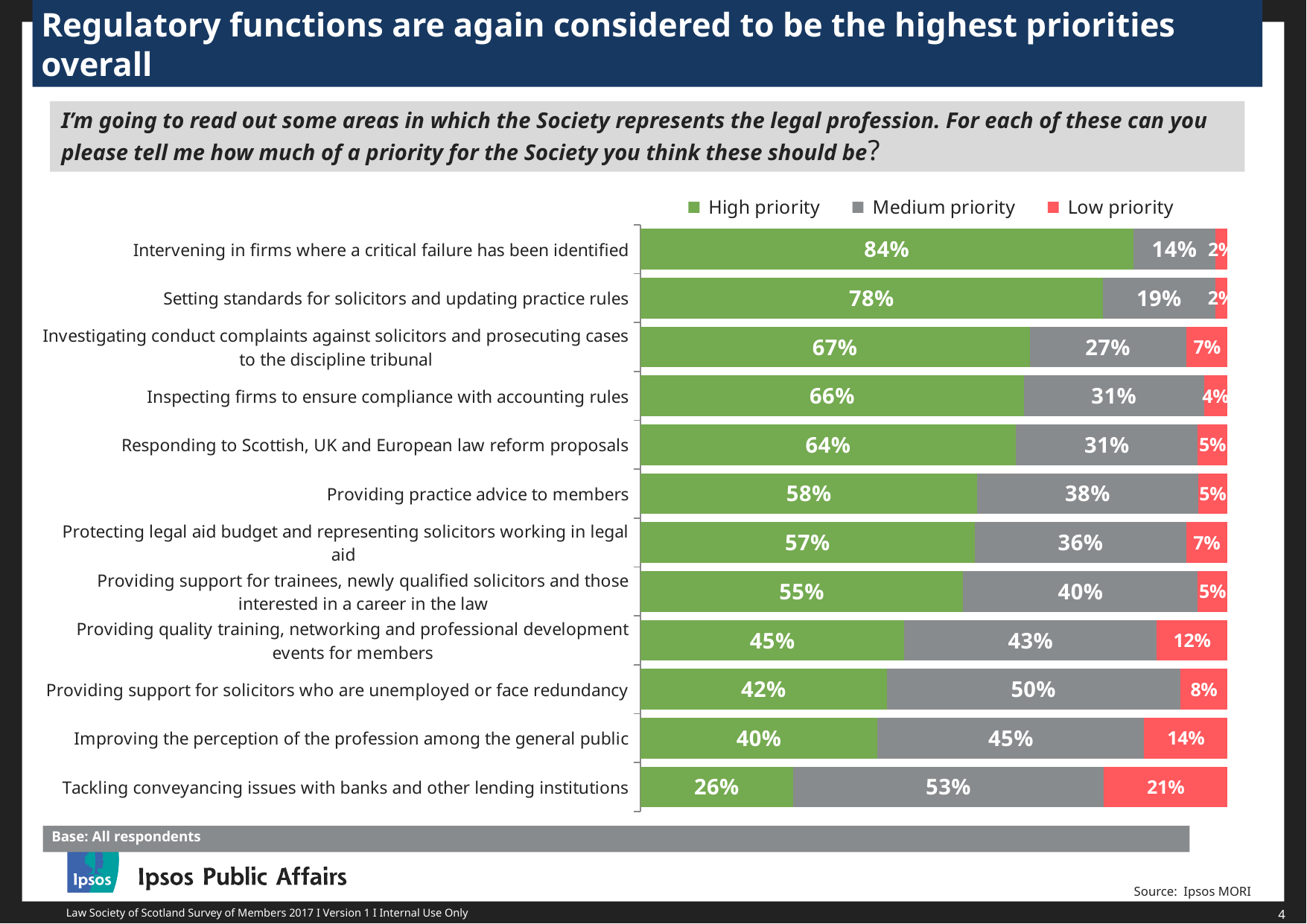
How many series does the legend list? 3 Which area has the lowest High priority percentage? Tackling conveyancing issues with banks and other lending institutions What type of chart is shown on the slide? Stacked bar chart What is the Low priority value for 'Improving the perception of the profession among the general public'? 14% Which has a larger High priority value: 'Providing support for solicitors who are unemployed or face redundancy' or 'Providing quality training, networking and professional development events for members'? Providing quality training, networking and professional development events for members What percentage of respondents rated 'Intervening in firms where a critical failure has been identified' as a high priority? 84% What is the difference between the High priority values for 'Setting standards for solicitors and updating practice rules' and 'Providing practice advice to members'? 20 percentage points Which area has the highest High priority percentage? Intervening in firms where a critical failure has been identified How many areas (categories) are shown in the chart? 12 What is the Medium priority value for 'Tackling conveyancing issues with banks and other lending institutions'? 53% Which area has the highest Low priority percentage? Tackling conveyancing issues with banks and other lending institutions Which colour represents 'Low priority' in the chart? Red